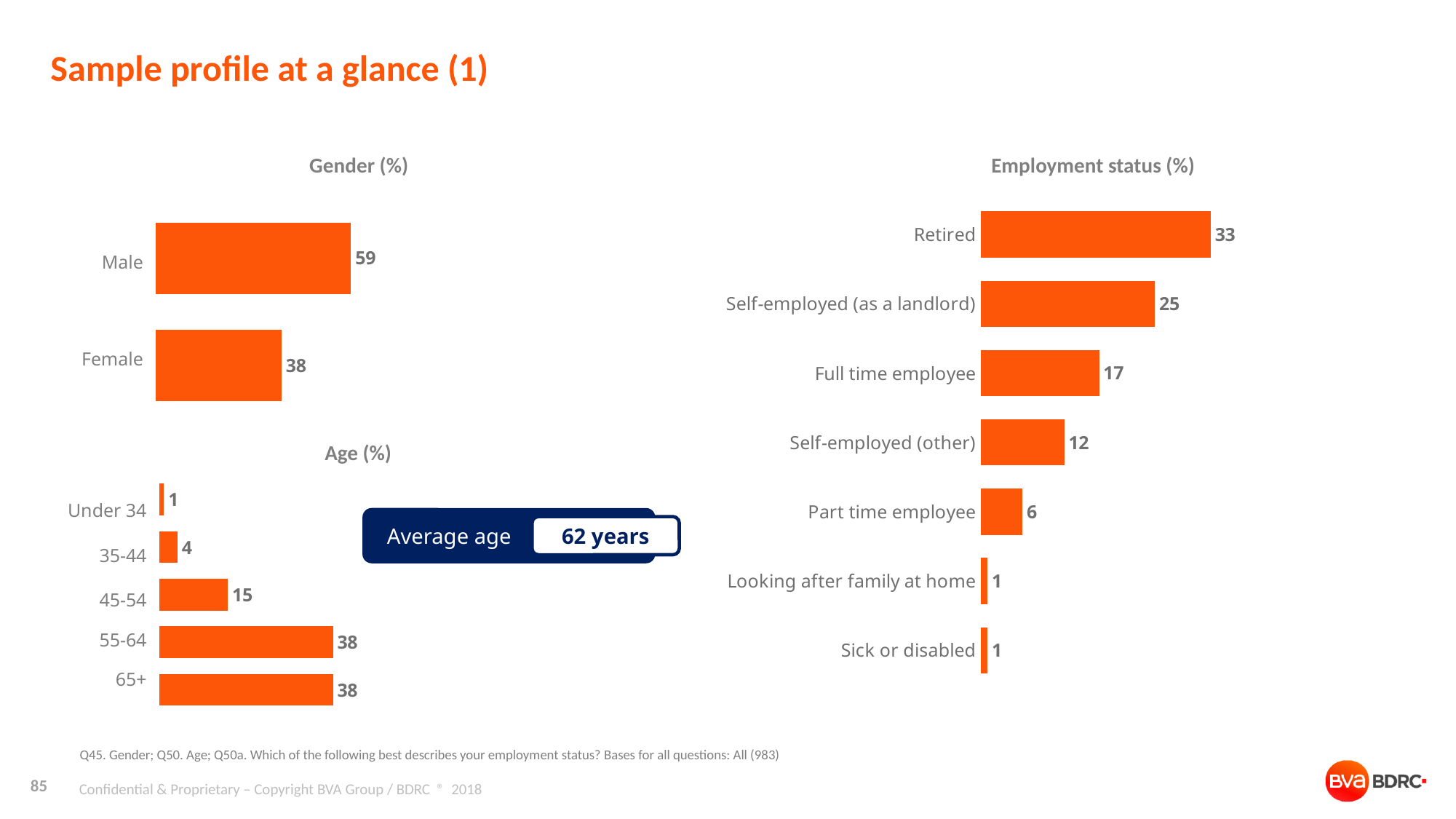
In the Gender (%) chart, what is the value for Male? 59 In the Employment status (%) chart, which category has the highest value? Retired In the Age (%) chart, is the value for 55-64 larger than the value for 35-44? Yes In the Gender (%) chart, what is the difference between the Male and Female values? 21 In the Employment status (%) chart, what is the value for Full time employee? 17 In the Age (%) chart, what is the value for 45-54? 15 What average age is shown in the box next to the Age (%) chart? 62 years What type of chart is the Employment status (%) chart? Bar chart In the Employment status (%) chart, how many categories are shown? 7 In the Age (%) chart, which age group has the lowest value? Under 34 In the Employment status (%) chart, what is the difference between Retired and Self-employed (as a landlord)? 8 In the Age (%) chart, how many age categories are shown? 5